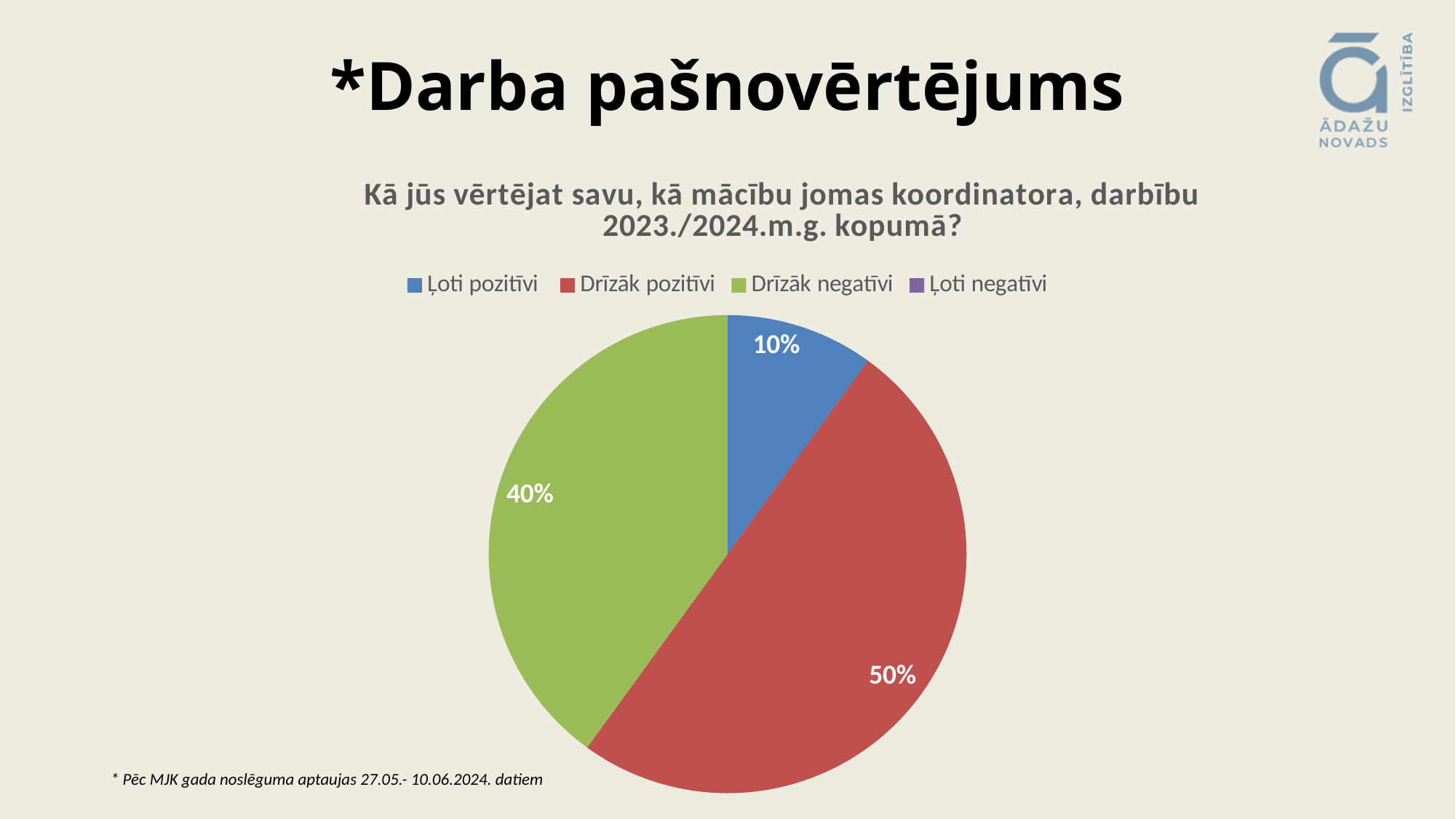
How many entries does the legend list? 4 What is the title of the chart? Kā jūs vērtējat savu, kā mācību jomas koordinatora, darbību 2023./2024.m.g. kopumā? What share of the pie is labelled "Ļoti pozitīvi"? 10% Which category with a visible slice has the smallest share of the pie? Ļoti pozitīvi What share of the pie is labelled "Drīzāk negatīvi"? 40% What is the difference in percentage points between the "Drīzāk pozitīvi" and "Drīzāk negatīvi" slices? 10 What is the combined share of the "Ļoti pozitīvi" and "Drīzāk pozitīvi" slices? 60% What share of the pie is labelled "Drīzāk pozitīvi"? 50% Which slice is larger: "Drīzāk negatīvi" or "Ļoti pozitīvi"? Drīzāk negatīvi What colour is the "Drīzāk negatīvi" slice? Green Which category has the largest slice of the pie? Drīzāk pozitīvi What kind of chart is shown on the slide? Pie chart